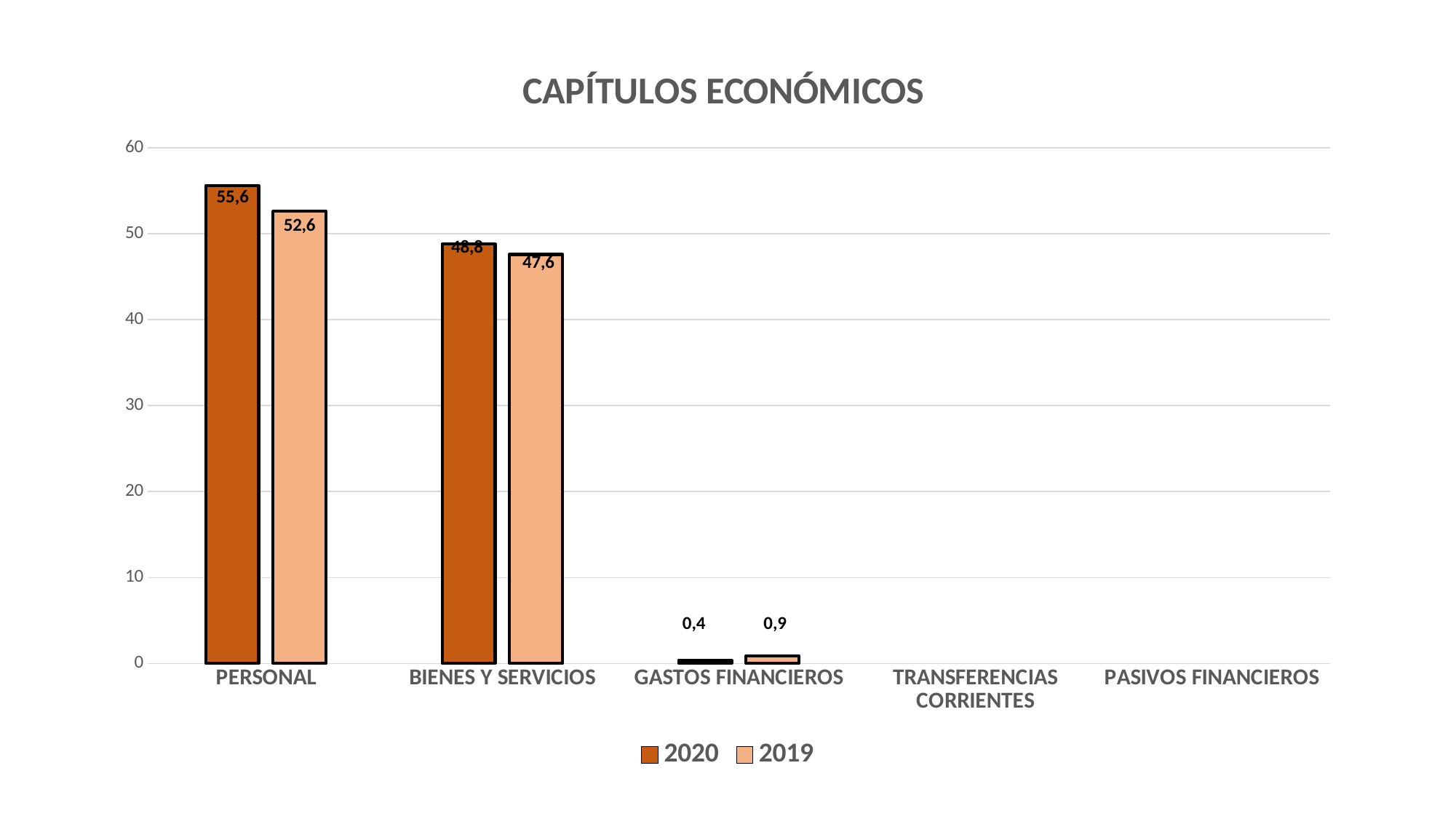
Which is larger for GASTOS FINANCIEROS, the 2020 value or the 2019 value? 2019 What is the value for GASTOS FINANCIEROS in the 2019 series? 0,9 How many categories are shown on the x axis? 5 What is the title of the chart? CAPÍTULOS ECONÓMICOS Is the 2019 value for PERSONAL greater or less than 50? greater What is the value for PERSONAL in the 2019 series? 52,6 What is the difference between the 2020 and 2019 values for PERSONAL? 3,0 What is the value for PERSONAL in the 2020 series? 55,6 What is the value for BIENES Y SERVICIOS in the 2019 series? 47,6 What is the value for GASTOS FINANCIEROS in the 2020 series? 0,4 Which category has the highest value in the 2020 series? PERSONAL How many series does the legend list? 2